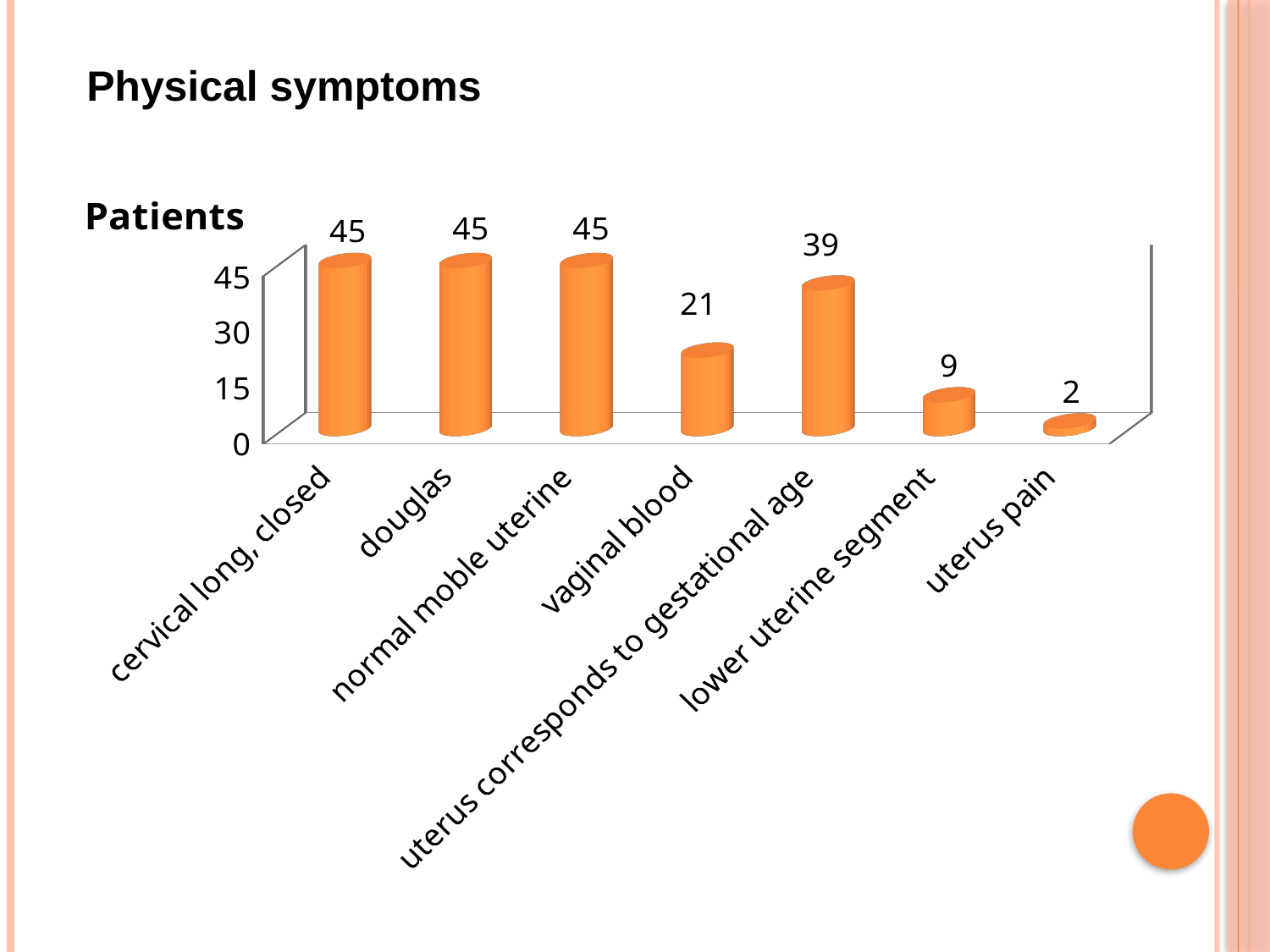
What is the value for vaginal blood? 21 What is the value for lower uterine segment? 9 What is the value for douglas? 45 What is the difference between the values for uterus corresponds to gestational age and vaginal blood? 18 What kind of chart is shown on the slide? bar chart How many categories are shown on the x axis? 7 What is the difference between the values for cervical long, closed and lower uterine segment? 36 What is the value for uterus corresponds to gestational age? 39 What is the title of the chart? Patients Which is larger, the value for vaginal blood or the value for lower uterine segment? vaginal blood Which category has the lowest value? uterus pain Is the value for uterus corresponds to gestational age greater or less than 30? greater